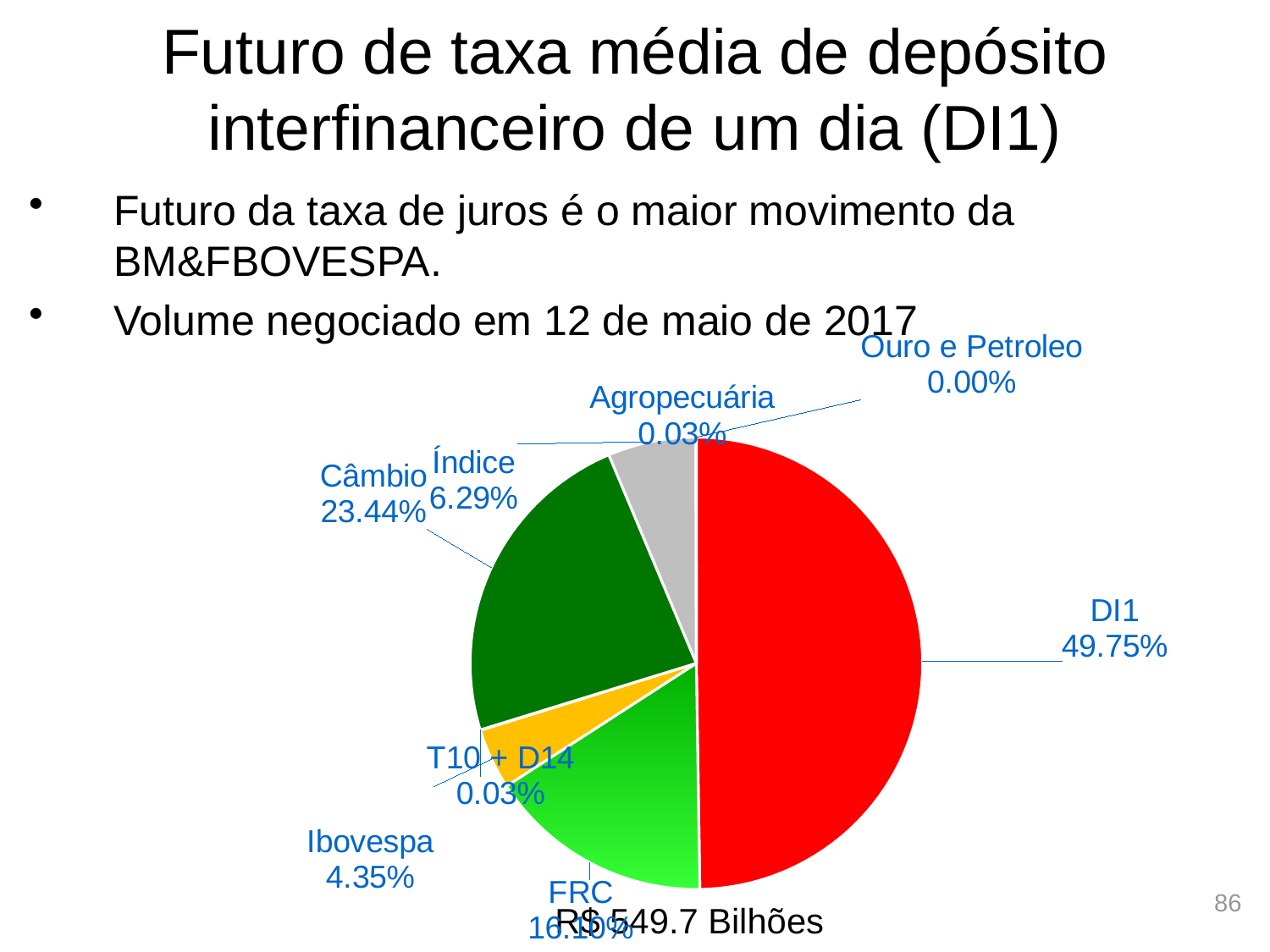
What colour is the DI1 slice of the pie? red What is the difference between the shares of DI1 and Câmbio? 26.31% What is the value shown for Câmbio? 23.44% What kind of chart is shown on the slide? pie chart What is the value shown for Ibovespa? 4.35% Which is larger, the share for Câmbio or the share for Índice? Câmbio What share of the pie does DI1 represent? 49.75% Which category has the smallest share of the pie? Ouro e Petroleo What is the value shown for Índice? 6.29% What is the value shown for Agropecuária? 0.03% Which category has the largest slice of the pie? DI1 How many categories are shown in the pie chart? 8